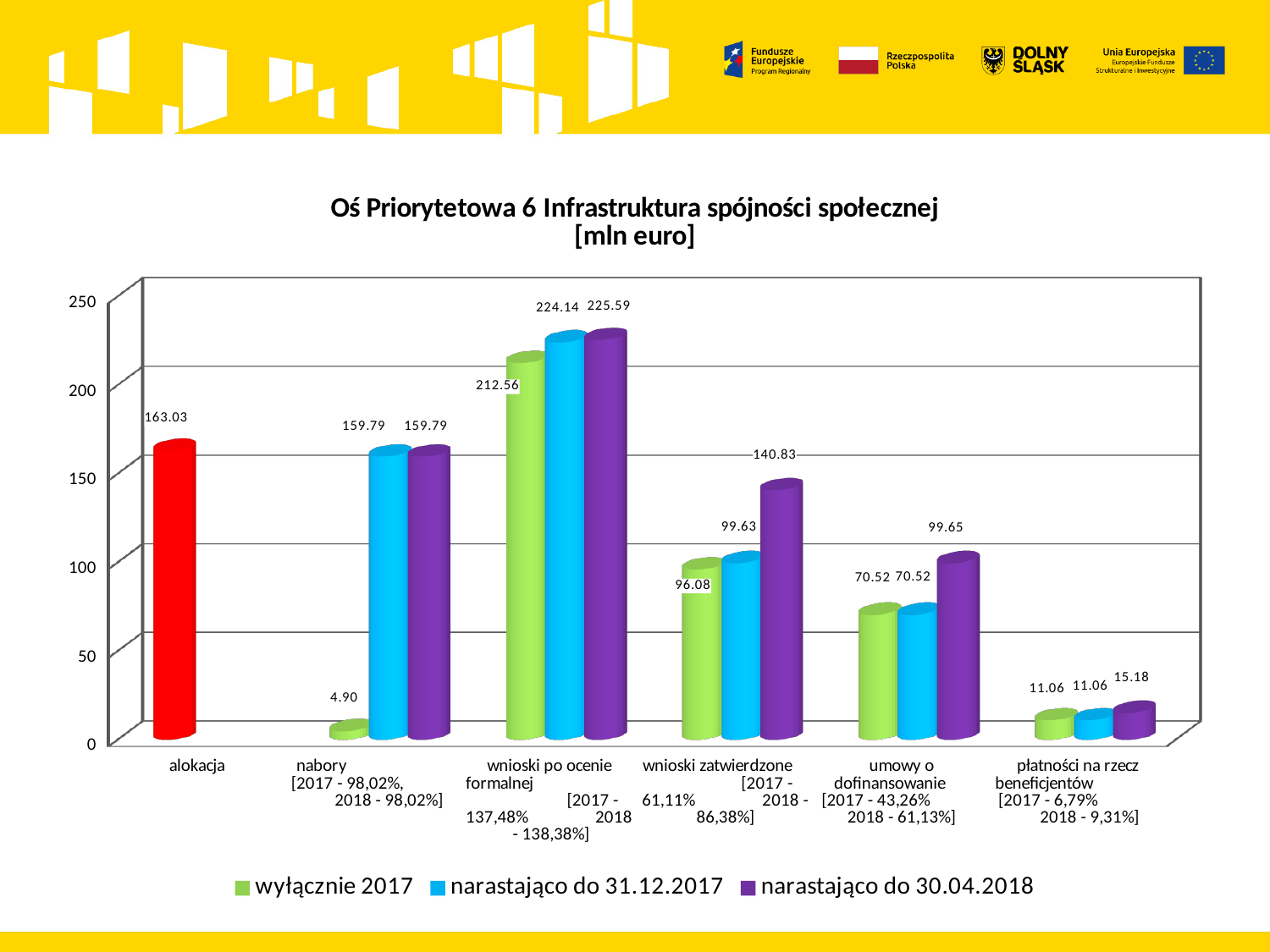
What is the difference between the 'narastająco do 30.04.2018' and 'narastająco do 31.12.2017' values for 'umowy o dofinansowanie'? 29.13 What is the 'narastająco do 30.04.2018' value for 'wnioski zatwierdzone'? 140.83 Which category has the lowest 'wyłącznie 2017' value? nabory What type of chart is shown on the slide? bar chart How many series does the legend list? 3 What is the 'wyłącznie 2017' value for 'nabory'? 4.90 How many categories are shown on the x axis? 6 What is the value of 'alokacja' on the chart? 163.03 What unit is given in the chart title? mln euro Which category has the highest 'narastająco do 30.04.2018' value? wnioski po ocenie formalnej What is the 'narastająco do 31.12.2017' value for 'wnioski po ocenie formalnej'? 224.14 Which is larger for 'płatności na rzecz beneficjentów': the 'wyłącznie 2017' value or the 'narastająco do 30.04.2018' value? narastająco do 30.04.2018